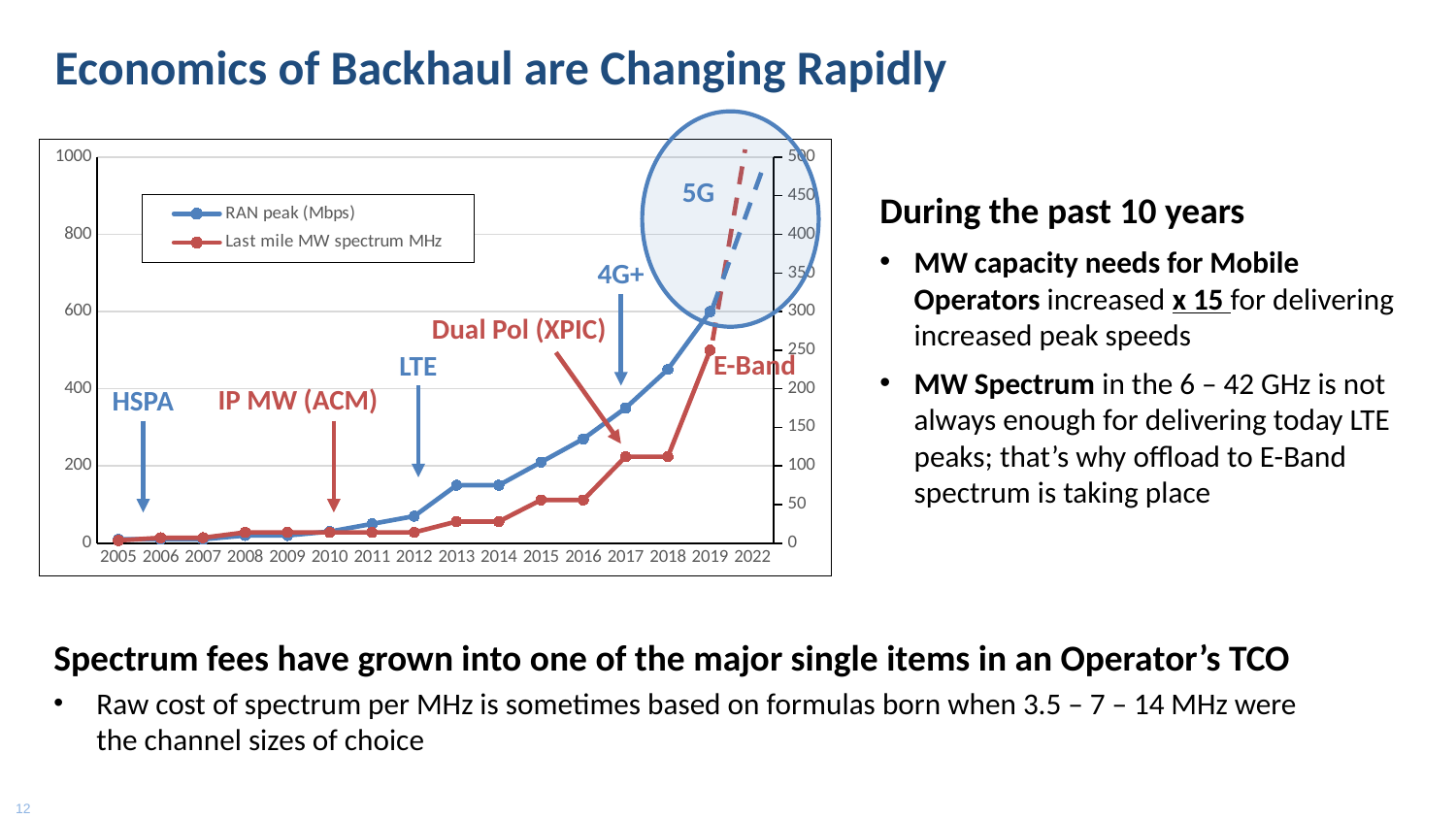
How many year labels are shown on the x axis of the chart? 16 What are the two series named in the chart legend? RAN peak (Mbps) and Last mile MW spectrum MHz Is the Last mile MW spectrum MHz value for 2019 greater or less than 200 on the right axis? greater Which technology label is annotated inside the circled region at the top right of the chart? 5G Is the RAN peak (Mbps) value for 2010 greater or less than 200? less How many series does the chart legend list? 2 Is the RAN peak (Mbps) value for 2019 greater or less than 400? greater Which year has the higher RAN peak (Mbps) value, 2015 or 2019? 2019 What kind of chart is shown on the slide? Line chart Does the RAN peak (Mbps) series rise or fall from 2005 to 2019? rise